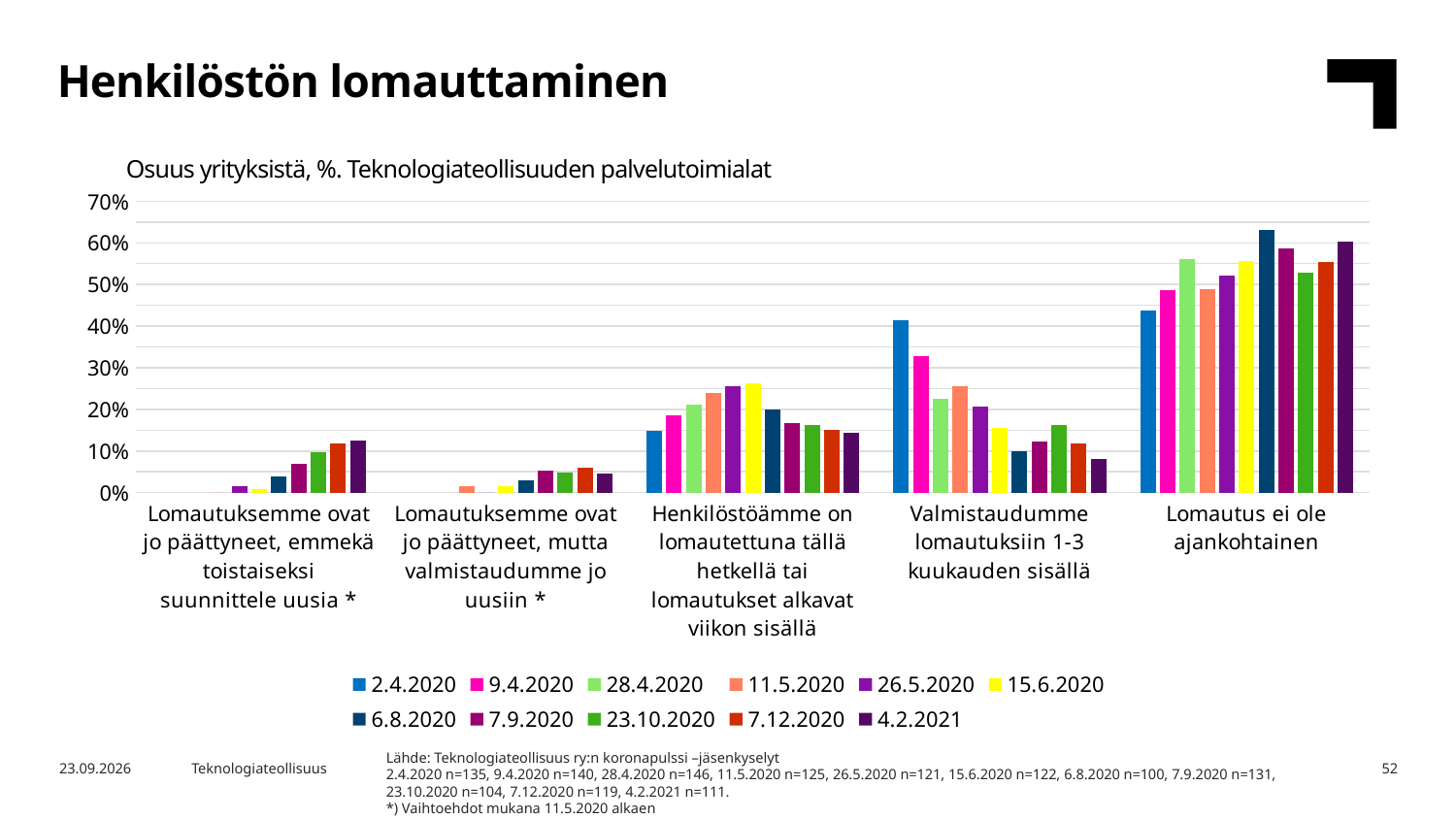
What is the subtitle printed above the chart? Osuus yrityksistä, %. Teknologiateollisuuden palvelutoimialat In the category "Lomautus ei ole ajankohtainen", which survey date has the highest value? 6.8.2020 Is the value for 2.4.2020 in the category "Valmistaudumme lomautuksiin 1-3 kuukauden sisällä" greater or less than 30%? greater Which category has the highest bar for the 6.8.2020 series? Lomautus ei ole ajankohtainen In the category "Valmistaudumme lomautuksiin 1-3 kuukauden sisällä", which is larger: the value for 2.4.2020 or for 4.2.2021? 2.4.2020 In the category "Valmistaudumme lomautuksiin 1-3 kuukauden sisällä", do the values generally rise or fall from 2.4.2020 to 4.2.2021? fall In the category "Valmistaudumme lomautuksiin 1-3 kuukauden sisällä", which survey date has the lowest value? 4.2.2021 How many response categories are shown along the x axis? 5 What kind of chart is shown on the slide? Bar chart How many survey dates (series) does the legend list? 11 Is the value for 6.8.2020 in the category "Lomautus ei ole ajankohtainen" greater or less than 60%? greater In the category "Henkilöstöämme on lomautettuna tällä hetkellä tai lomautukset alkavat viikon sisällä", which is larger: the value for 15.6.2020 or for 2.4.2020? 15.6.2020